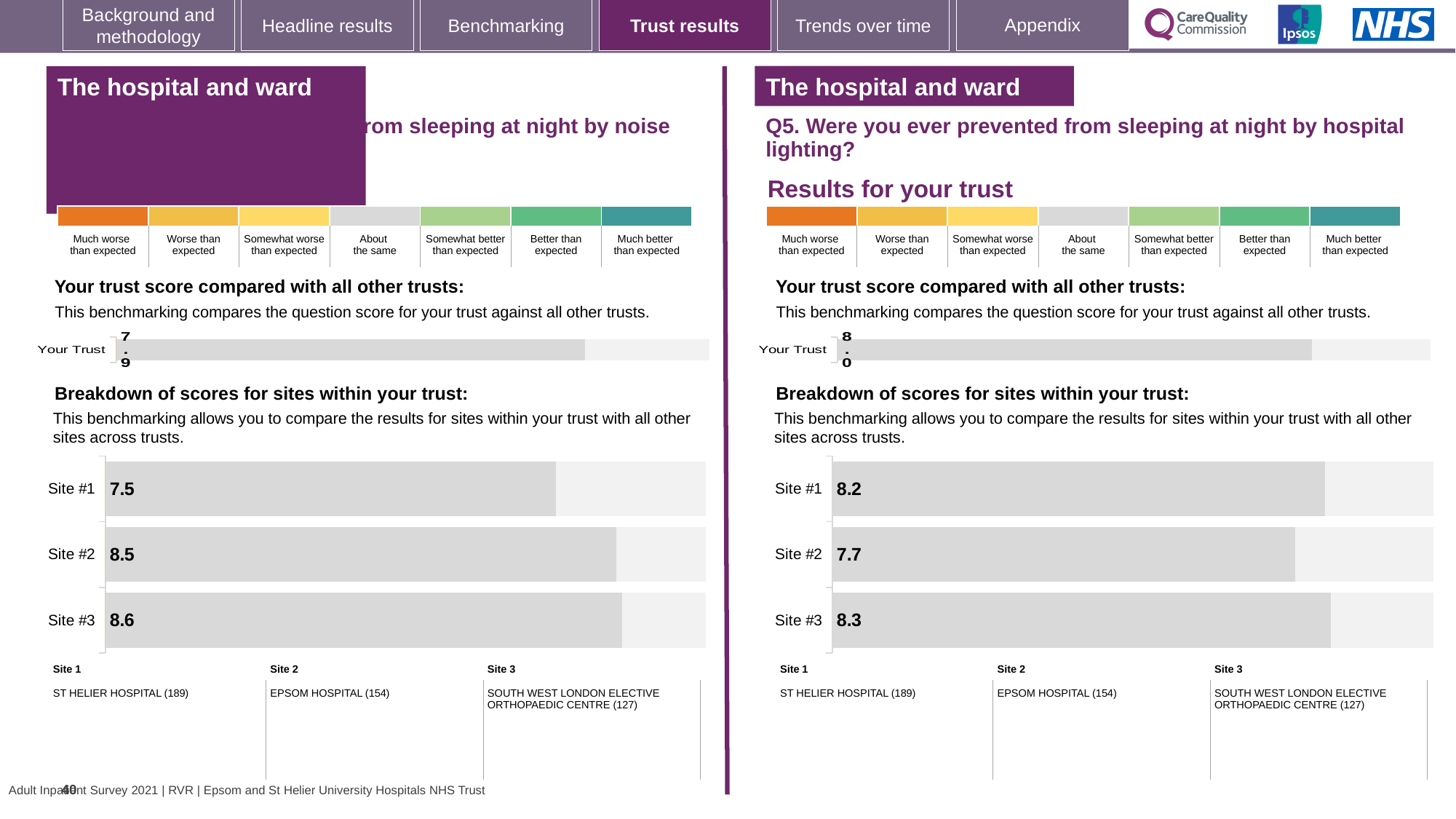
On the left-hand chart (sleeping at night by noise), which site has the lowest score? Site #1 How many sites are shown in the site breakdown chart on the right-hand side (Q5, hospital lighting)? 3 On the right-hand chart (Q5, hospital lighting), what is the score for Site #3? 8.3 On the right-hand chart (Q5, hospital lighting), what is the score for Site #2? 7.7 What type of chart is used for the breakdown of scores for sites on the right-hand side (Q5, hospital lighting)? Bar chart On the left-hand chart (sleeping at night by noise), what is the score for Site #1? 7.5 On the left-hand chart (sleeping at night by noise), what is the score for Site #3? 8.6 On the left-hand chart (sleeping at night by noise), what is the difference between the scores for Site #3 and Site #1? 1.1 On the right-hand chart (Q5, hospital lighting), what is the score for Site #1? 8.2 On the right-hand chart (Q5, hospital lighting), what is the difference between the scores for Site #3 and Site #2? 0.6 On the right-hand chart (Q5, hospital lighting), which site has the lowest score? Site #2 On the right-hand chart (Q5, hospital lighting), which is larger: the score for Site #1 or Site #2? Site #1